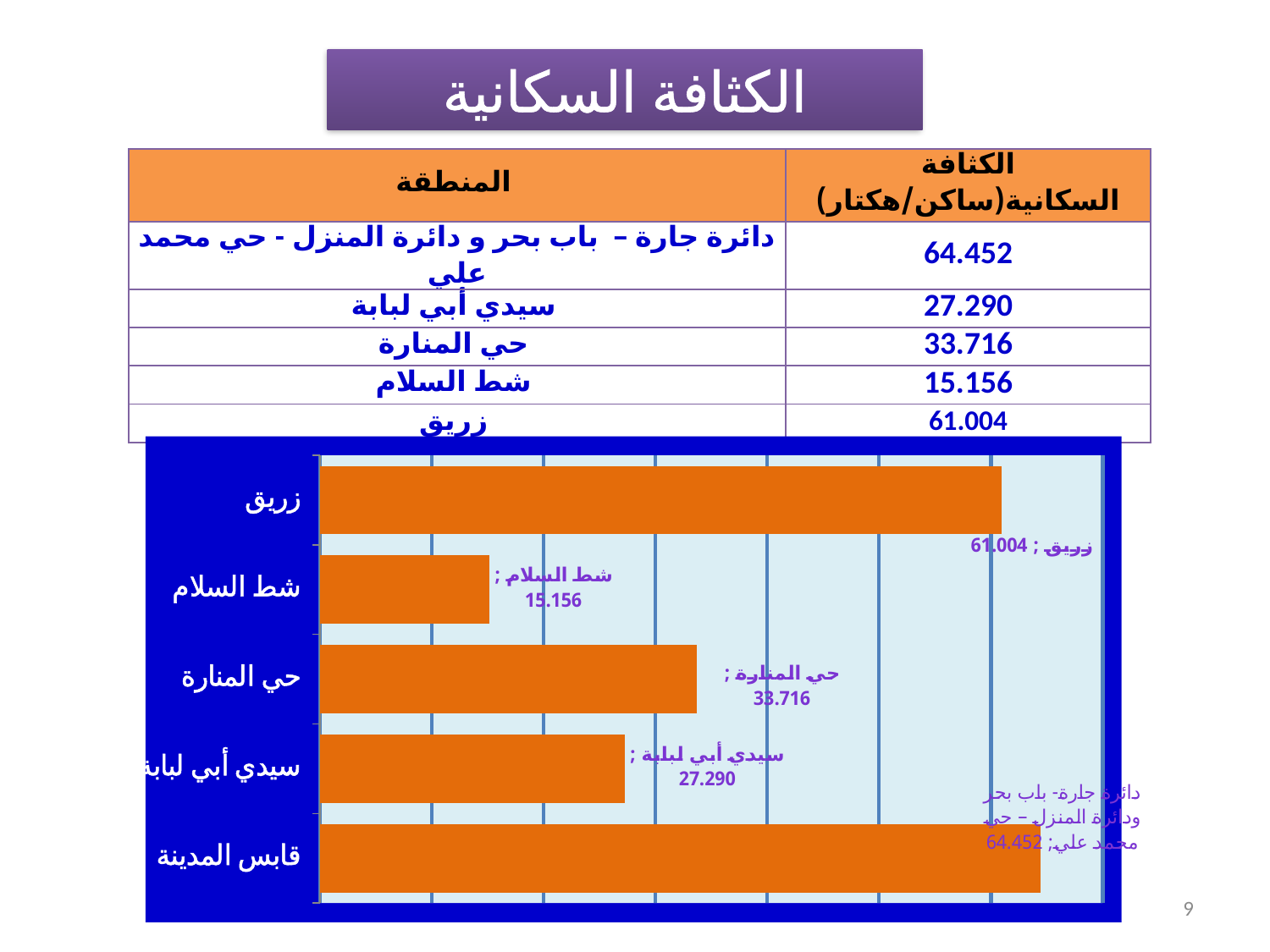
Which has a larger value in the bar chart, حي المنارة or سيدي أبي لبابة? حي المنارة What is the value shown for سيدي أبي لبابة in the bar chart? 27.290 Which category has the lowest value in the bar chart? شط السلام What is the difference between the values for حي المنارة and سيدي أبي لبابة in the bar chart? 6.426 What is the difference between the values for زريق and شط السلام in the bar chart? 45.848 What is the value shown for حي المنارة in the bar chart? 33.716 What is the value shown for شط السلام in the bar chart? 15.156 What is the value shown for زريق in the bar chart? 61.004 How many categories (areas) are plotted in the bar chart? 5 What type of chart is shown on the slide? bar chart What is the value shown for قابس المدينة in the bar chart? 64.452 Which category has the highest value in the bar chart? قابس المدينة